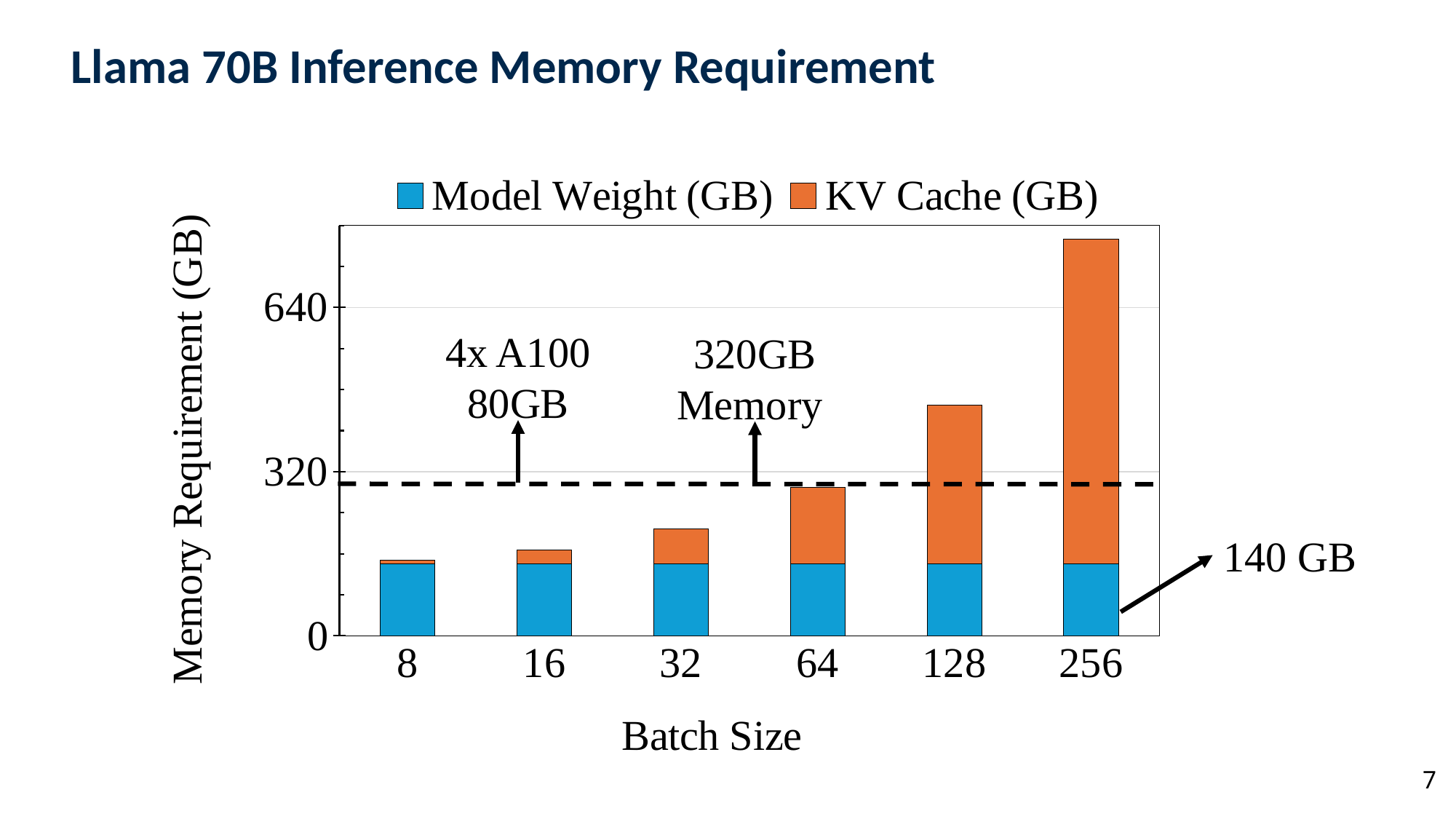
What is the Model Weight memory value indicated by the arrow annotation? 140 GB Does the total memory requirement rise or fall as batch size increases? Rises How many series does the legend list? 2 What is the label of the x axis? Batch Size Which batch size has the highest total memory requirement? 256 Is the total memory requirement for batch size 128 greater or less than 320? greater Which has a larger KV Cache (GB) value, batch size 64 or batch size 128? Batch size 128 Is the total memory requirement for batch size 32 greater or less than 320? less How many batch sizes are plotted on the x axis? 6 What kind of chart is shown on the slide? Stacked bar chart Which batch size has the lowest total memory requirement? 8 Is the total memory requirement for batch size 256 greater or less than 640? greater